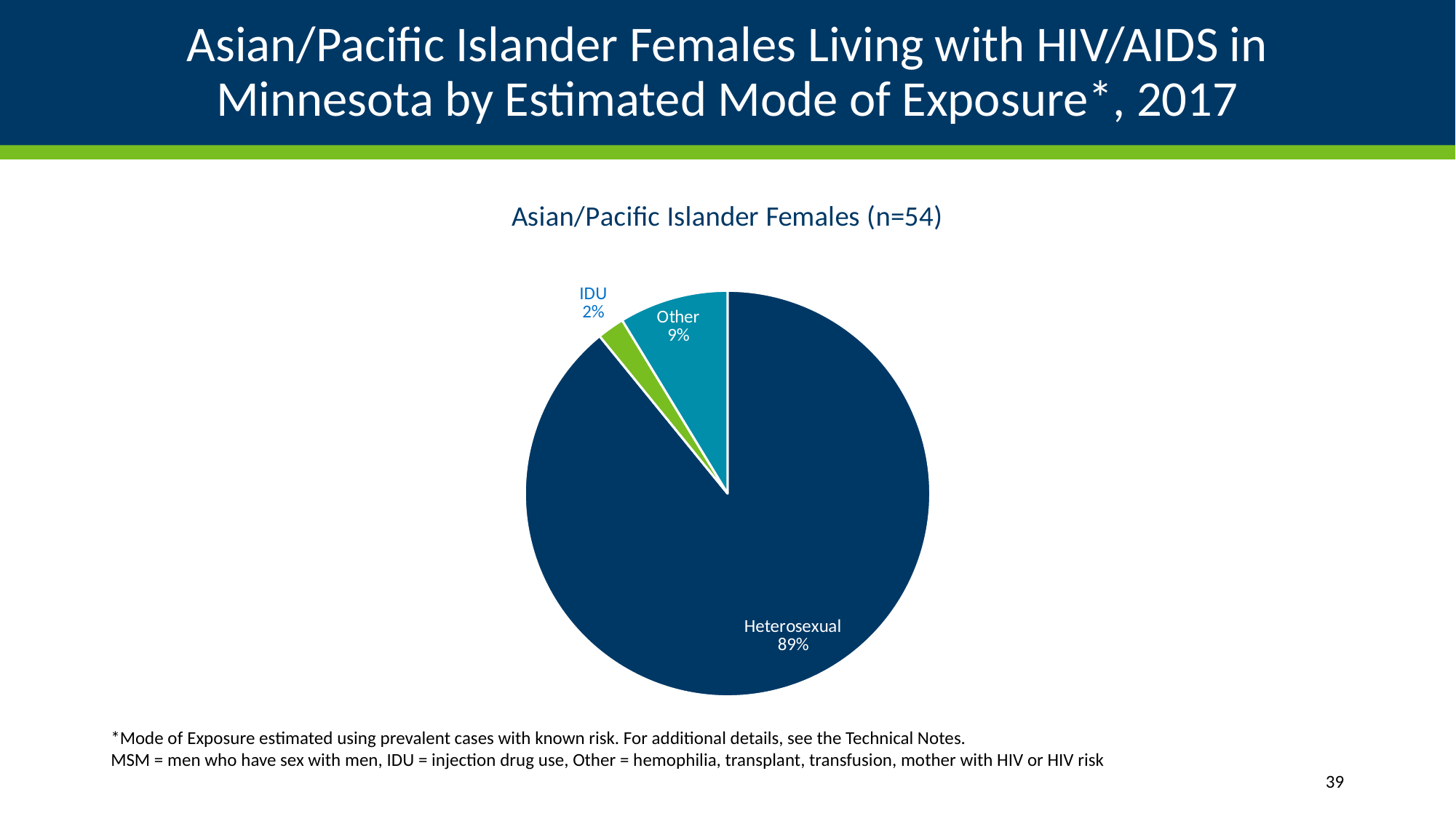
What colour is the IDU slice? green What percentage of the pie is Other? 9% What is the sample size (n) shown in the chart title? 54 Which mode of exposure has the largest share of the pie? Heterosexual What percentage of the pie is IDU? 2% What is the difference in percentage points between the Heterosexual and Other slices? 80 Which slice is larger, Other or IDU? Other What type of chart is shown on the slide? pie chart How many slices does the pie chart have? 3 Which mode of exposure has the smallest share of the pie? IDU What is the combined share of the Other and IDU slices? 11% What percentage of the pie is Heterosexual? 89%